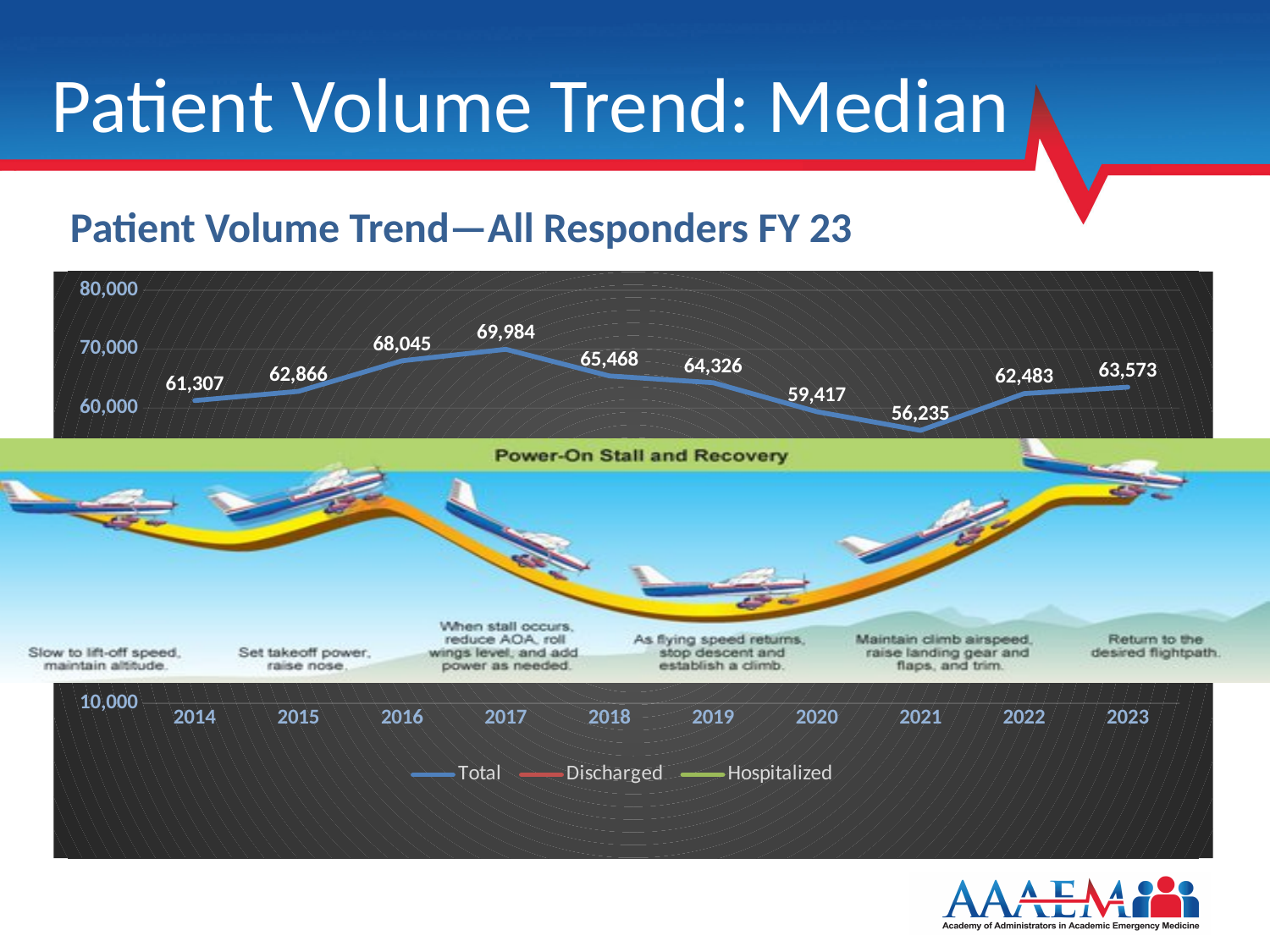
What is the Total patient volume for 2021? 56,235 How many years are shown on the x axis? 10 How many series does the legend list? 3 Is the Total patient volume for 2020 greater or less than 60,000? less What kind of chart is shown on the slide? line chart Does the Total patient volume rise or fall from 2021 to 2023? rise Which year has the lowest Total patient volume? 2021 Which year has the highest Total patient volume? 2017 What is the Total patient volume for 2017? 69,984 What is the Total patient volume for 2023? 63,573 Which is larger, the Total patient volume in 2016 or in 2018? 2016 What is the difference between the Total patient volume in 2017 and in 2021? 13,749